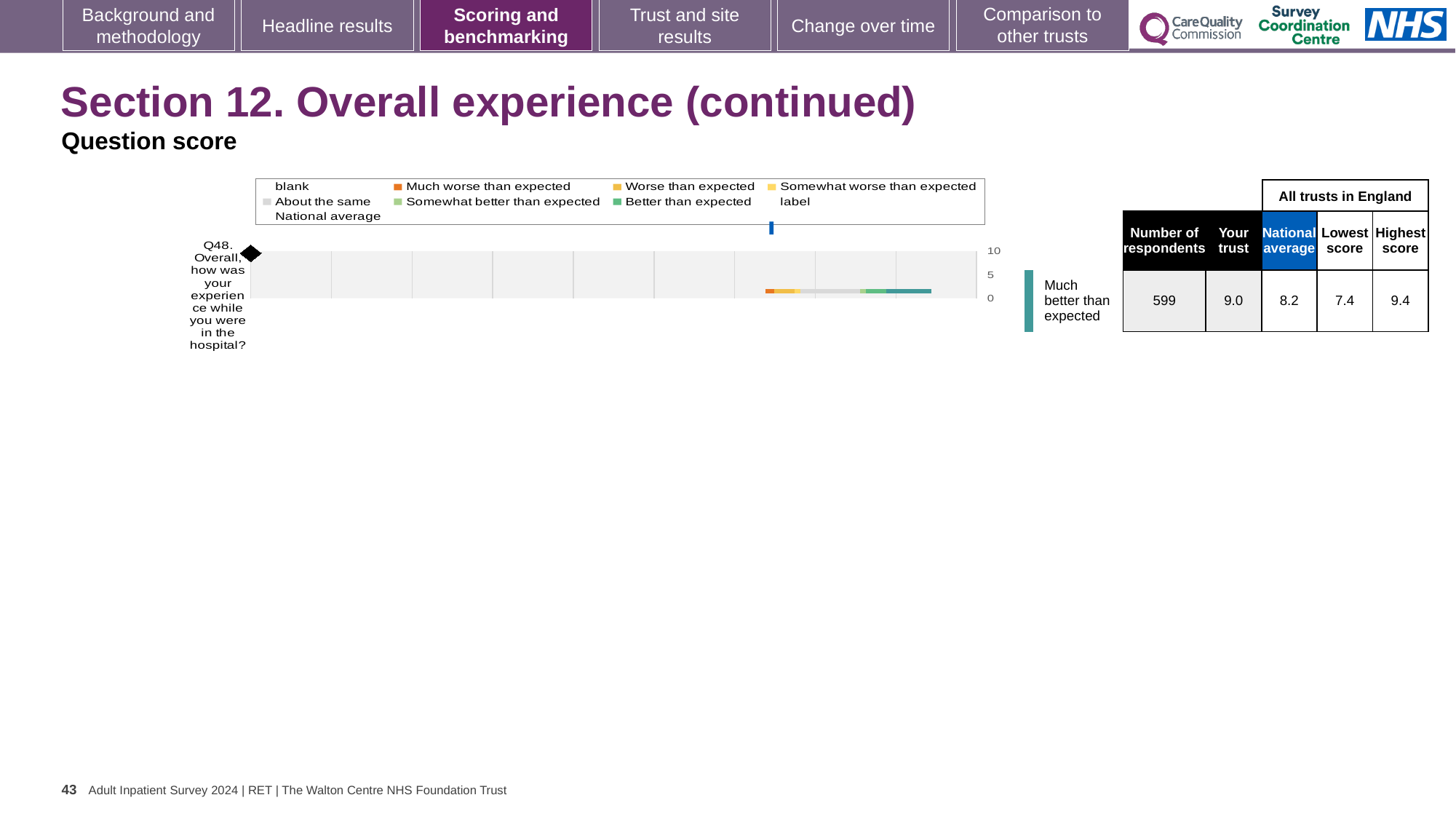
What kind of chart is shown on the slide for Q48? bar chart What is the highest score among all trusts in England for Q48? 9.4 What benchmark category is the trust's Q48 result assigned to? Much better than expected Which question is plotted in the chart? Q48. Overall, how was your experience while you were in the hospital? What is the highest value shown on the chart's axis? 10 What is the national average score for Q48 in the table beside the chart? 8.2 What is the lowest score among all trusts in England for Q48? 7.4 How many respondents answered Q48? 599 What is the difference between the trust's score and the national average for Q48? 0.8 Is the trust's score for Q48 higher or lower than the national average? higher What is the 'Your trust' score for Q48 in the table beside the chart? 9.0 How many survey questions are plotted in the chart? 1